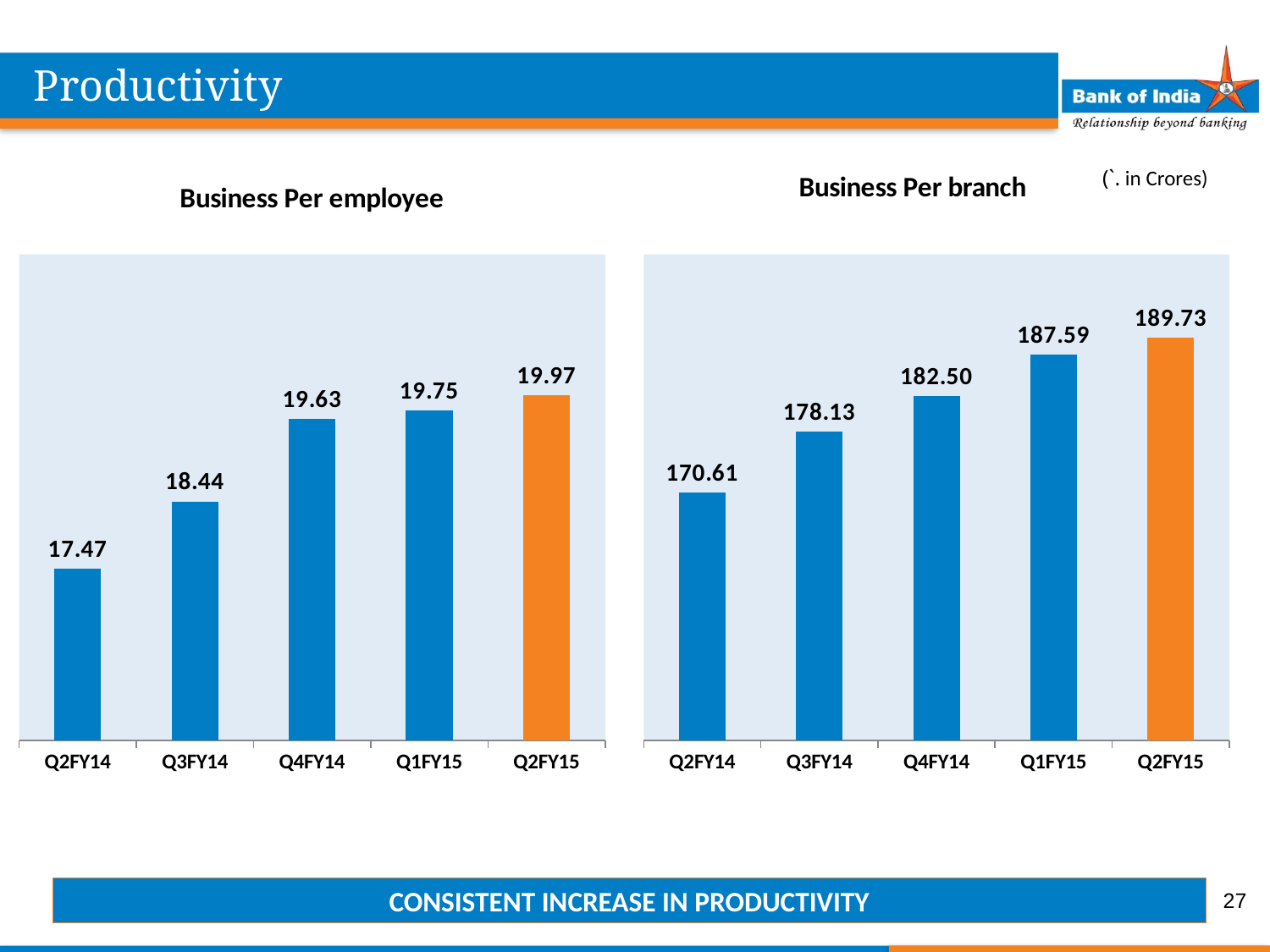
In the Business Per employee chart, what is the difference between the Q2FY15 and Q2FY14 values? 2.50 How many quarters are shown in the Business Per branch chart? 5 In the Business Per branch chart, which bar is coloured orange? Q2FY15 In the Business Per branch chart, what is the difference between the Q1FY15 and Q4FY14 values? 5.09 In the Business Per branch chart, what is the value for Q4FY14? 182.50 In the Business Per branch chart, do the values rise or fall from Q2FY14 to Q2FY15? Rise In the Business Per employee chart, which is larger, the value for Q3FY14 or Q4FY14? Q4FY14 In the Business Per employee chart, which quarter has the lowest value? Q2FY14 What kind of chart is the Business Per employee chart? Bar chart In the Business Per branch chart, which quarter has the highest value? Q2FY15 In the Business Per employee chart, what is the value for Q3FY14? 18.44 In the Business Per employee chart, what is the value for Q2FY15? 19.97